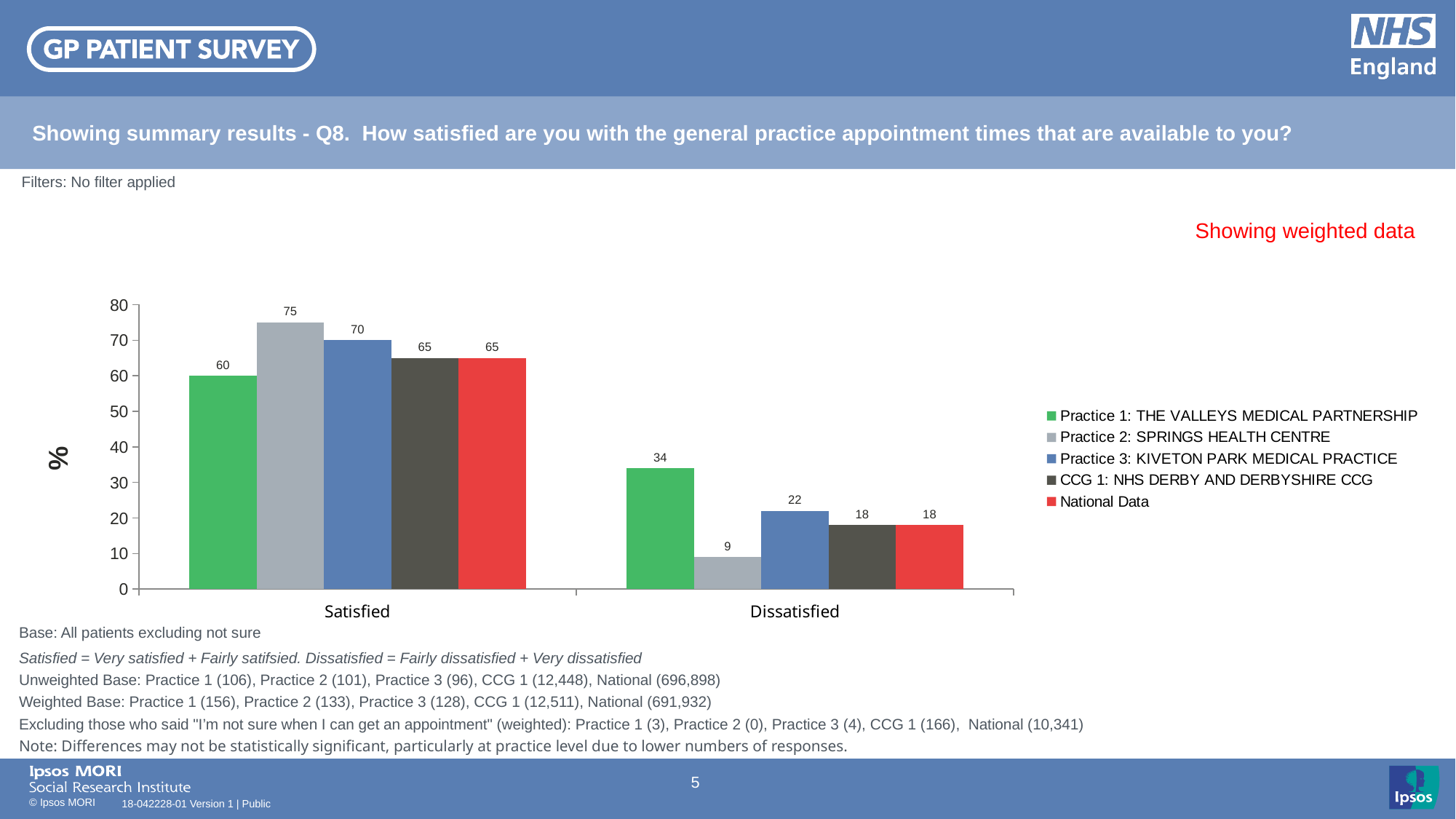
What is the Satisfied value for Practice 2: SPRINGS HEALTH CENTRE? 75 Which is larger: the Dissatisfied value for Practice 3: KIVETON PARK MEDICAL PRACTICE or for CCG 1: NHS DERBY AND DERBYSHIRE CCG? Practice 3: KIVETON PARK MEDICAL PRACTICE Which series has the highest Satisfied value? Practice 2: SPRINGS HEALTH CENTRE What is the Dissatisfied value for Practice 1: THE VALLEYS MEDICAL PARTNERSHIP? 34 How many categories are shown on the x axis? 2 How many series does the legend list? 5 What is the difference between the Satisfied values for Practice 2: SPRINGS HEALTH CENTRE and Practice 1: THE VALLEYS MEDICAL PARTNERSHIP? 15 Which series has the lowest Dissatisfied value? Practice 2: SPRINGS HEALTH CENTRE What is the Satisfied value for National Data? 65 Is the Satisfied value for Practice 3: KIVETON PARK MEDICAL PRACTICE greater or less than 60? greater What kind of chart is shown on the slide? bar chart What colour represents National Data in the chart? red